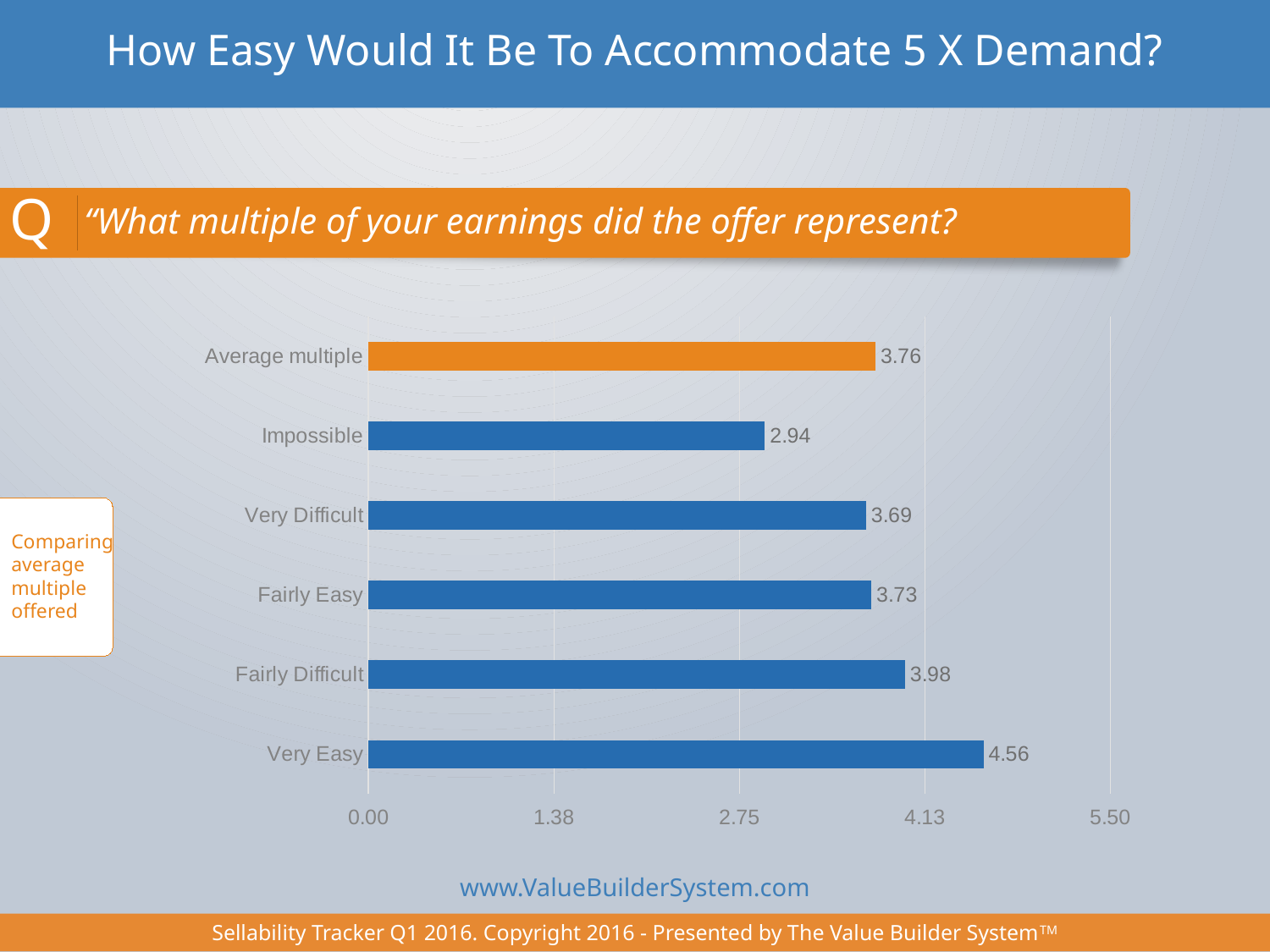
What is the value for Fairly Difficult? 3.98 Which category has the highest value? Very Easy What is the difference between the values for Very Easy and Impossible? 1.62 Which category has the lowest value? Impossible How many categories are shown in the chart? 6 What is the value for Average multiple? 3.76 Which bar is coloured orange rather than blue? Average multiple Is the value for Impossible greater or less than 2.75? greater What kind of chart is shown on the slide? Bar chart Which is larger, the value for Fairly Difficult or the value for Very Difficult? Fairly Difficult What is the value for Very Easy? 4.56 What is the value for Impossible? 2.94